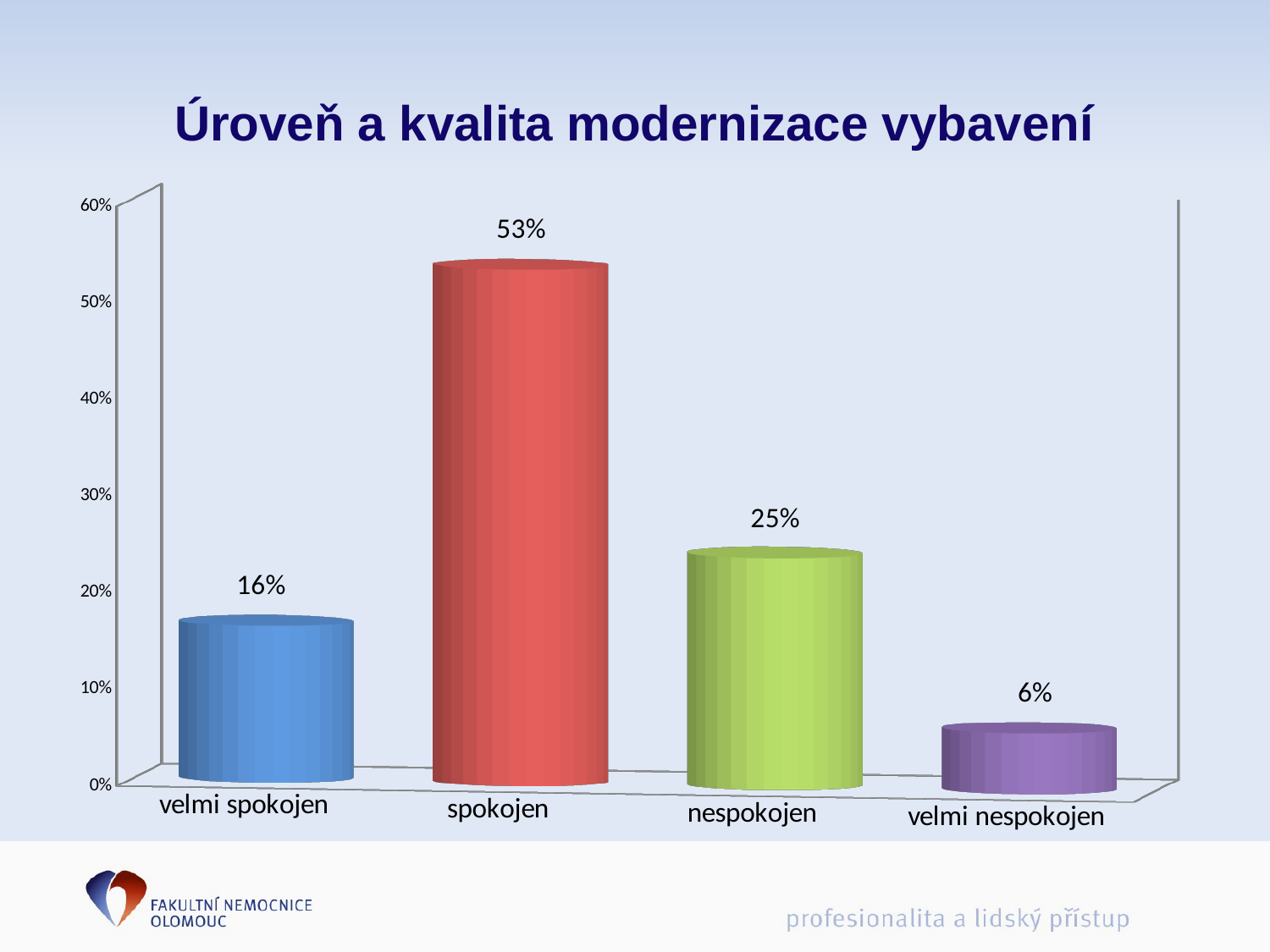
What is the value for "velmi nespokojen"? 6% Which category has the lowest value? velmi nespokojen What is the difference between the values for "velmi spokojen" and "velmi nespokojen"? 10% What is the value for "spokojen"? 53% What kind of chart is shown on the slide? bar chart Is the value for "spokojen" greater or less than 50%? greater Which category has the highest value? spokojen What is the difference between the values for "spokojen" and "nespokojen"? 28% What is the value for "velmi spokojen"? 16% What is the value for "nespokojen"? 25% Which is larger, the value for "velmi spokojen" or the value for "nespokojen"? nespokojen How many categories are shown on the x axis? 4